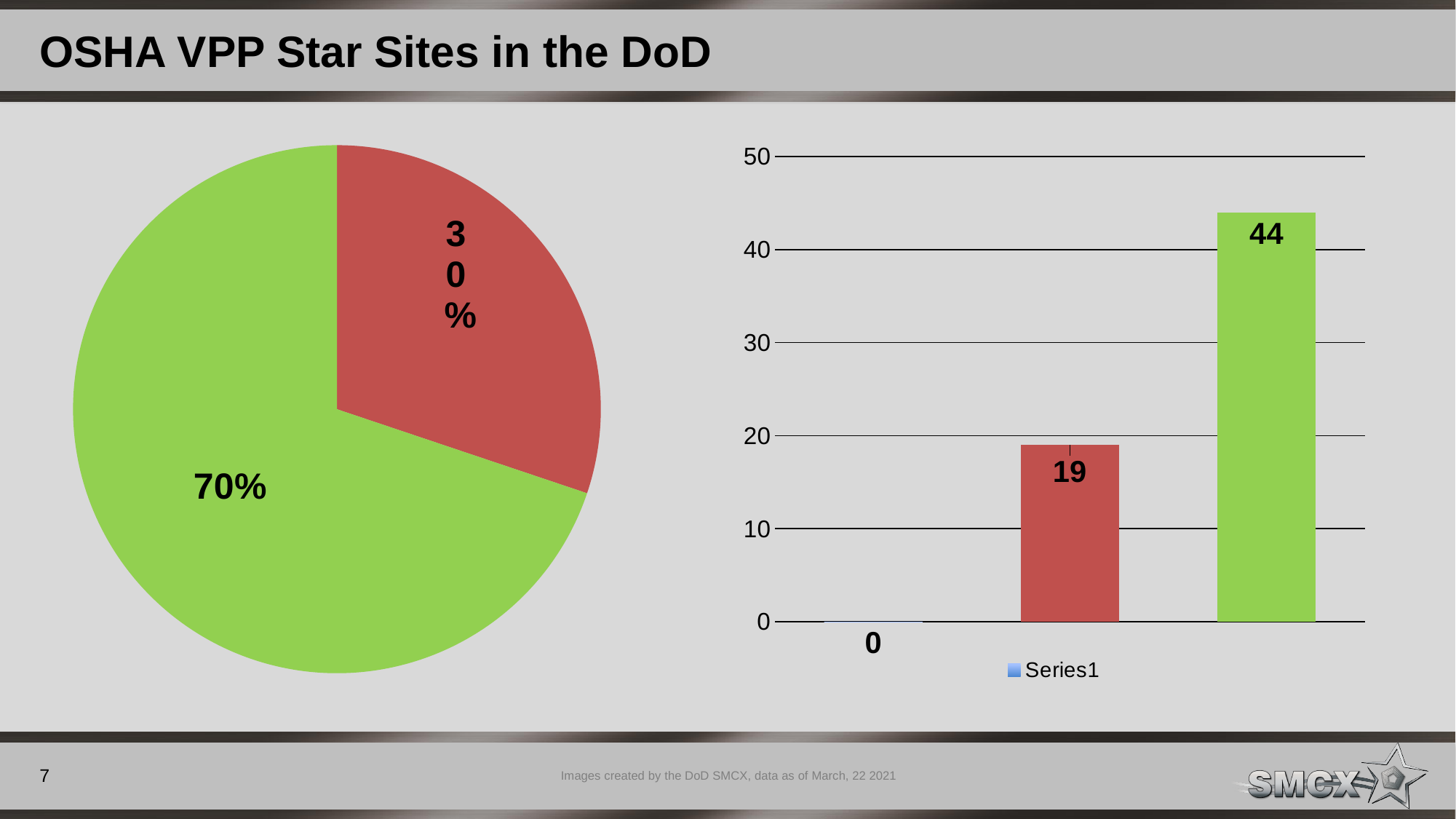
In the pie chart on the left, what percentage does the red slice show? 30% In the pie chart on the left, how many slices are there? 2 What kind of chart is on the left side of the slide? pie chart In the pie chart on the left, what percentage does the green slice show? 70% In the bar chart on the right, what is the value of the first (leftmost) bar? 0 In the bar chart on the right, what is the value of the red bar? 19 In the pie chart on the left, which slice is larger, the green one or the red one? green In the bar chart on the right, what is the difference between the green bar and the red bar? 25 In the bar chart on the right, how many bars are plotted? 3 What kind of chart is on the right side of the slide? bar chart In the bar chart on the right, what is the value of the green bar? 44 In the bar chart on the right, what entry does the legend list? Series1